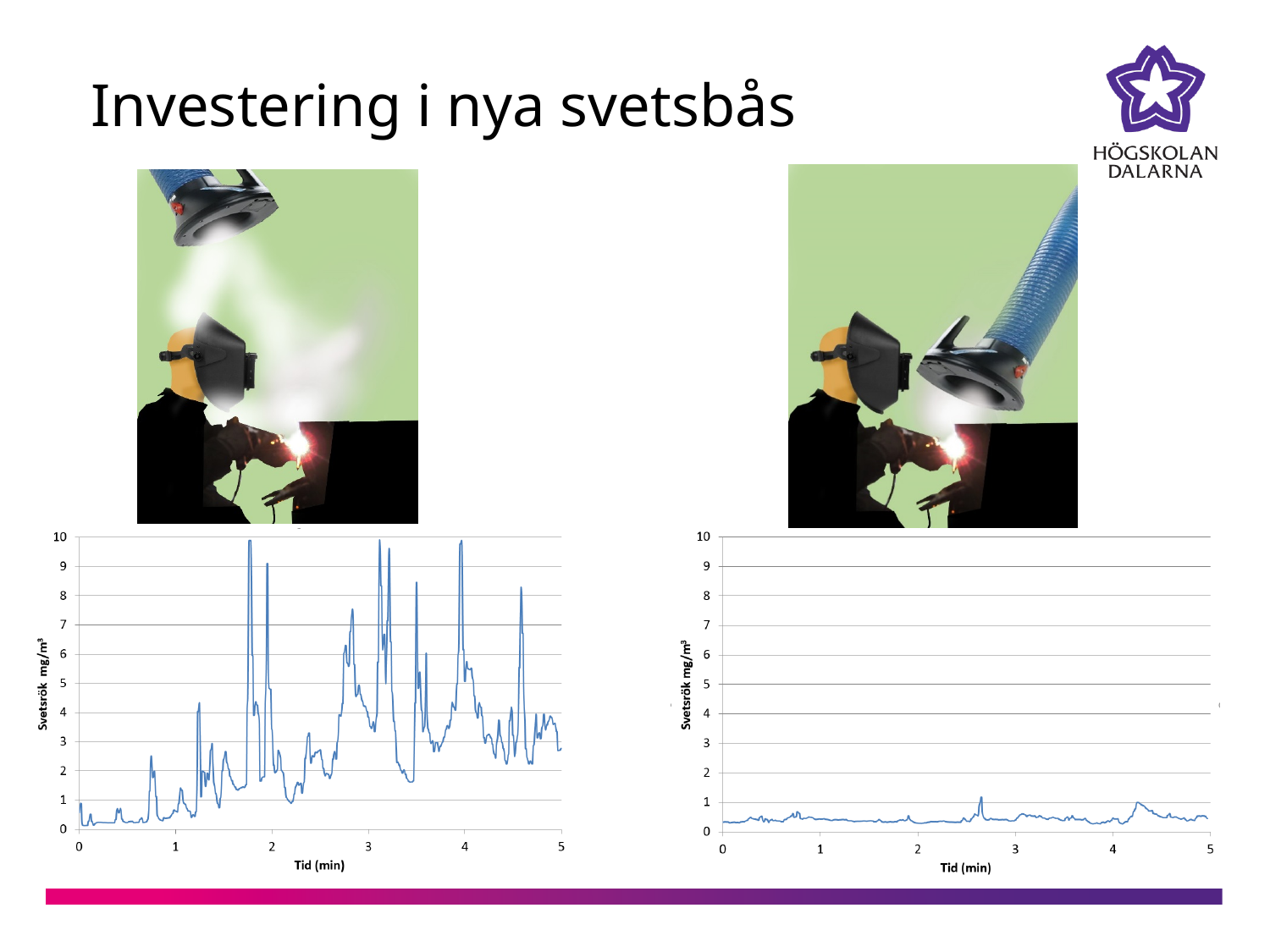
In the chart on the right of the slide, is the value at 4 min greater or less than 2? less Which chart reaches the higher peak value, the chart on the left or the chart on the right of the slide? the chart on the left What is the x-axis label of the chart on the right of the slide? Tid (min) How many charts are shown on the slide? 2 What kind of chart is the chart on the right of the slide? line chart In the chart on the left of the slide, does the line ever rise above 8? yes In the chart on the left of the slide, is the value at 3 min greater or less than 2? greater What kind of chart is the chart on the left of the slide? line chart What is the y-axis label of the chart on the left of the slide? Svetsrök mg/m³